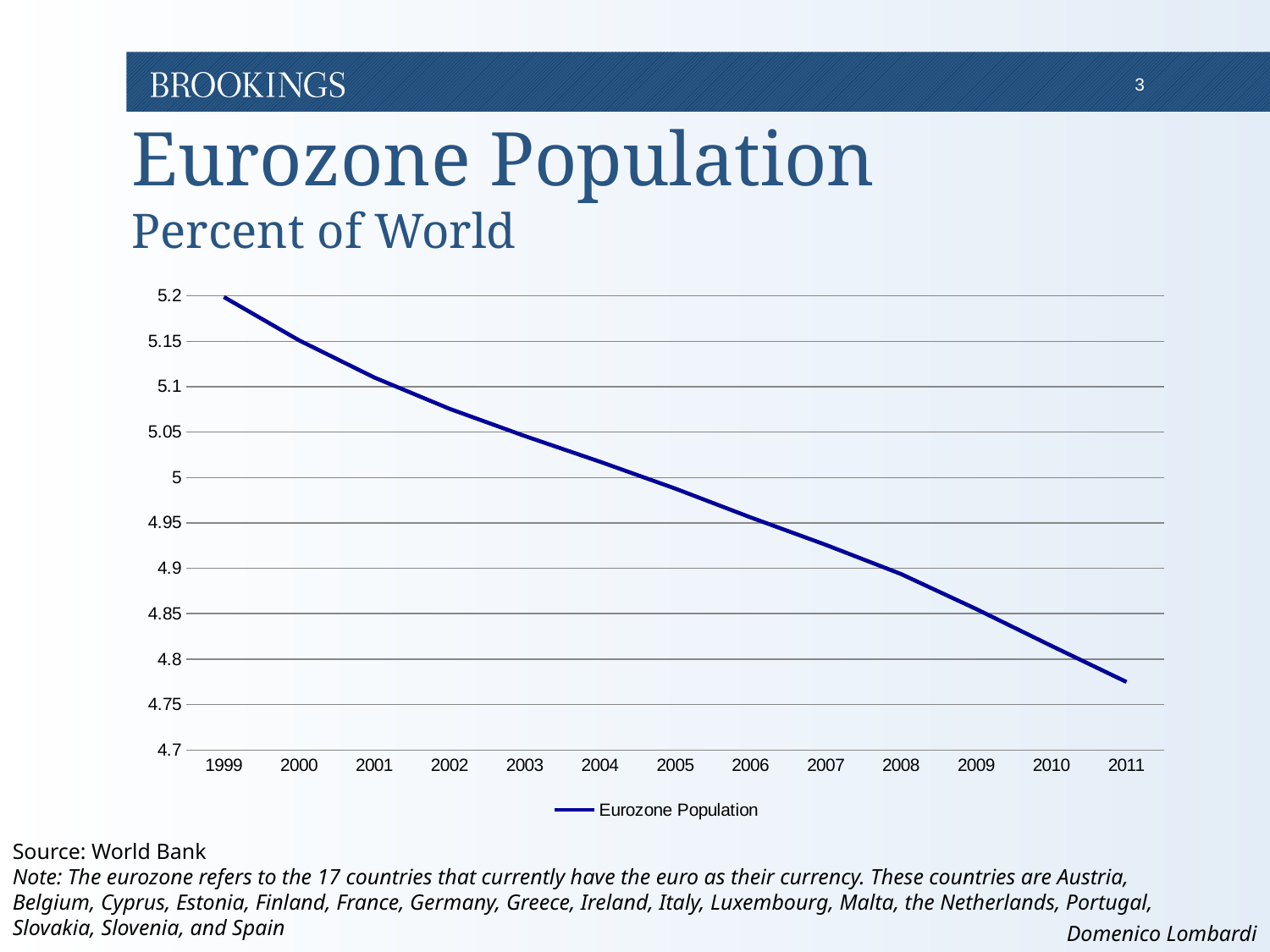
Which year has the lowest eurozone population share of the world? 2011 Is the value for 2009 greater or less than 4.9? less Which year has the highest eurozone population share of the world? 1999 What kind of chart is shown on the slide? line chart Is the value for 2011 greater or less than 4.8? less How many years are plotted on the x axis? 13 Is the value for 2006 greater or less than 5? less How many series does the legend list? 1 What is the name of the series shown in the legend? Eurozone Population Which year has the larger value, 2000 or 2008? 2000 Do the values rise or fall from 1999 to 2011? fall